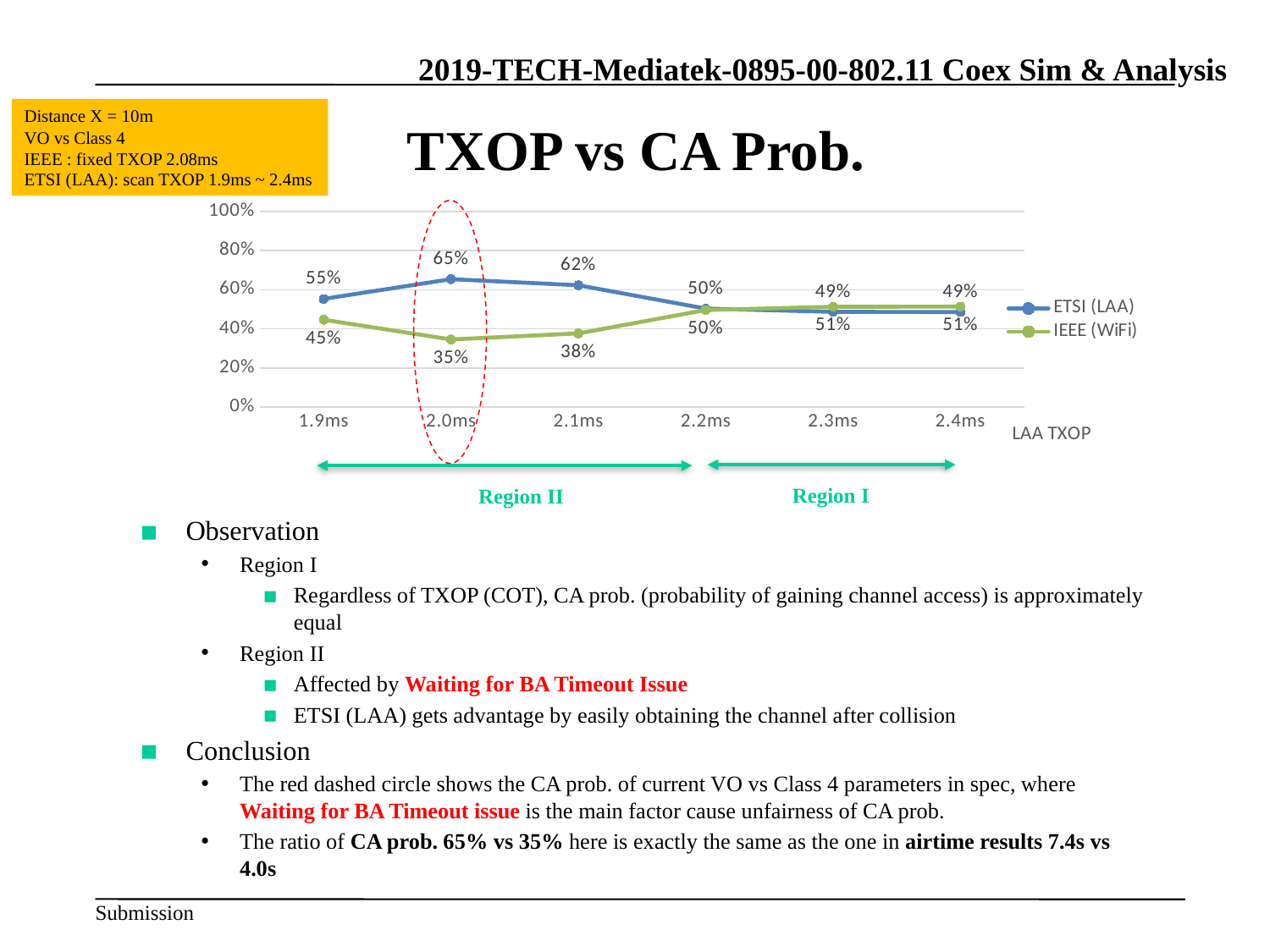
What is the IEEE (WiFi) value at 2.1ms? 38% At which LAA TXOP value is the IEEE (WiFi) series lowest? 2.0ms At which LAA TXOP value is the ETSI (LAA) series highest? 2.0ms What is the IEEE (WiFi) value at 2.0ms? 35% Does the IEEE (WiFi) series rise or fall from 2.0ms to 2.4ms? Rise How many LAA TXOP categories are shown on the x axis? 6 What kind of chart is shown on the slide? Line chart Which series has the larger value at 2.1ms, ETSI (LAA) or IEEE (WiFi)? ETSI (LAA) What is the difference between the ETSI (LAA) and IEEE (WiFi) values at 2.0ms? 30% How many series does the legend list? 2 What is the ETSI (LAA) value at 1.9ms? 55% What is the ETSI (LAA) value at 2.0ms? 65%